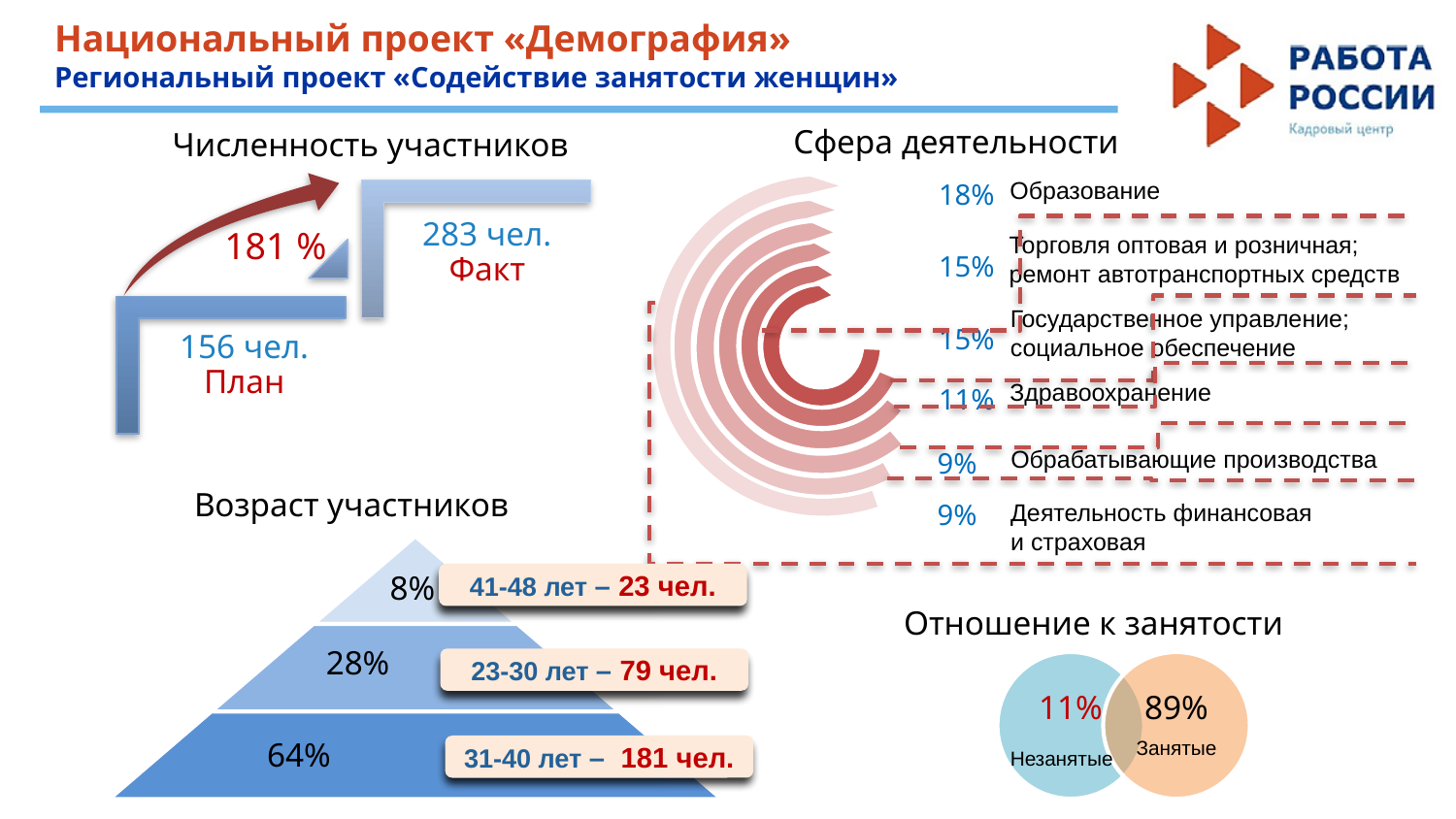
На диаграмме «Возраст участников» сколько человек в группе 23-30 лет? 79 чел. На диаграмме «Сфера деятельности» на сколько процентных пунктов доля «Образование» больше доли «Здравоохранение»? 7 На диаграмме «Возраст участников» какая возрастная группа самая многочисленная? 31-40 лет На диаграмме «Возраст участников» на сколько человек группа 31-40 лет больше группы 23-30 лет? 102 чел. На диаграмме «Сфера деятельности» какая доля приходится на «Образование»? 18% На диаграмме «Сфера деятельности» сколько сфер деятельности показано? 6 На диаграмме «Возраст участников» какова доля группы 31-40 лет? 64% На диаграмме «Сфера деятельности» что больше: доля «Здравоохранение» или доля «Обрабатывающие производства»? Здравоохранение На диаграмме «Численность участников» на сколько человек факт превышает план? 127 чел. На диаграмме «Возраст участников» какая возрастная группа самая малочисленная? 41-48 лет На диаграмме «Отношение к занятости» какая доля участников относится к «Занятые»? 89% На диаграмме «Сфера деятельности» какая сфера имеет наибольшую долю? Образование